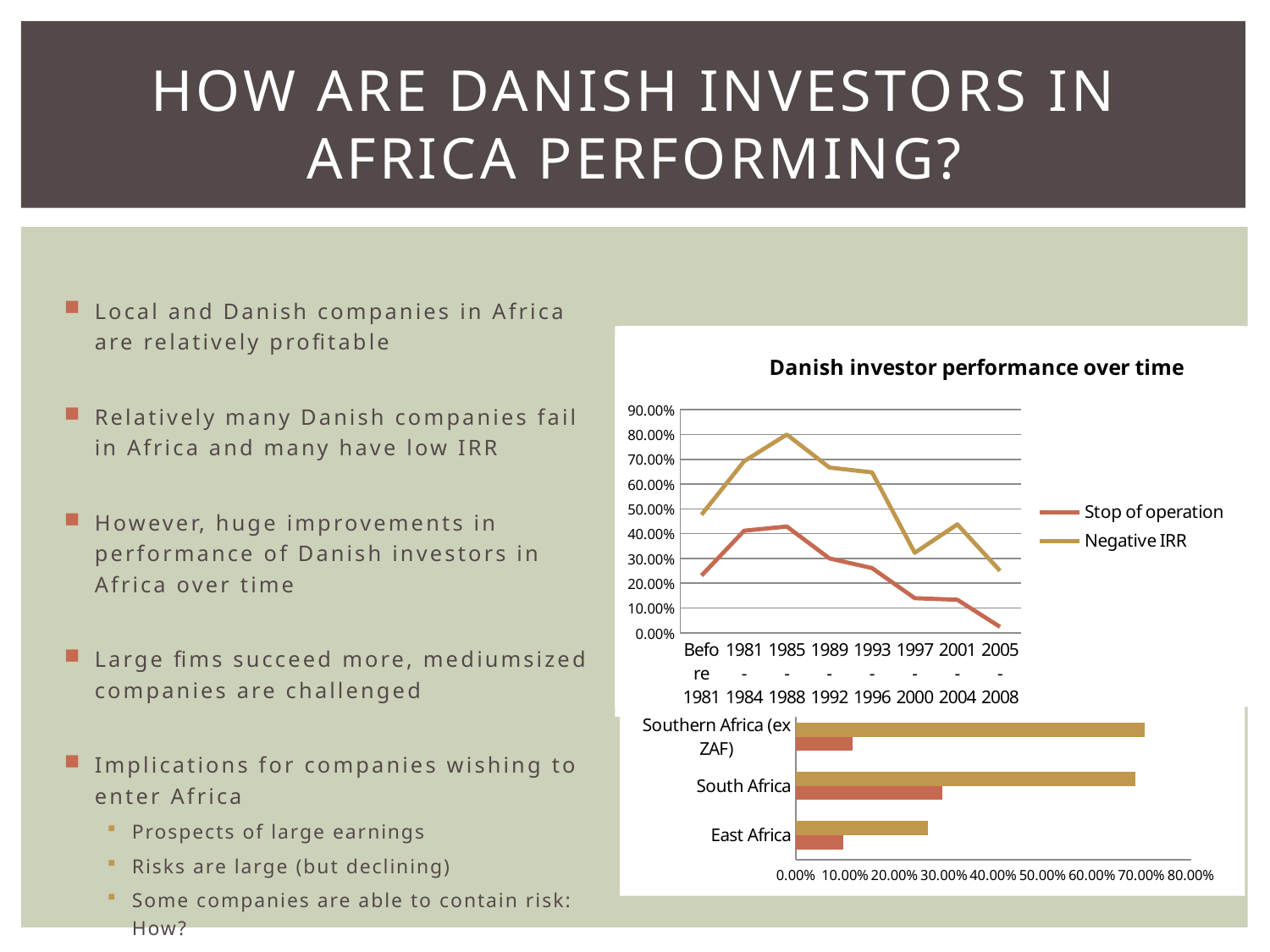
In 'Danish investor performance over time', how many time periods are shown on the x axis? 8 In 'Danish investor performance over time', which series has the higher value in 1993-1996, Stop of operation or Negative IRR? Negative IRR In 'Danish investor performance over time', is the Stop of operation value for 2005-2008 greater or less than 10.00%? less In 'Danish investor performance over time', does Stop of operation rise or fall from 1985-1988 to 2005-2008? Fall In the bar chart at the bottom right of the slide, which region has the longest red bar? South Africa In 'Danish investor performance over time', how many series does the legend list? 2 In 'Danish investor performance over time', in which period is Stop of operation lowest? 2005-2008 What type of chart is the chart at the bottom right of the slide showing Southern Africa (ex ZAF), South Africa and East Africa? Bar chart In the bar chart at the bottom right of the slide, how many regions are listed? 3 What type of chart is 'Danish investor performance over time'? Line chart In 'Danish investor performance over time', in which period does Negative IRR reach its highest value? 1985-1988 In 'Danish investor performance over time', is the Negative IRR value for 1985-1988 greater or less than 70.00%? greater